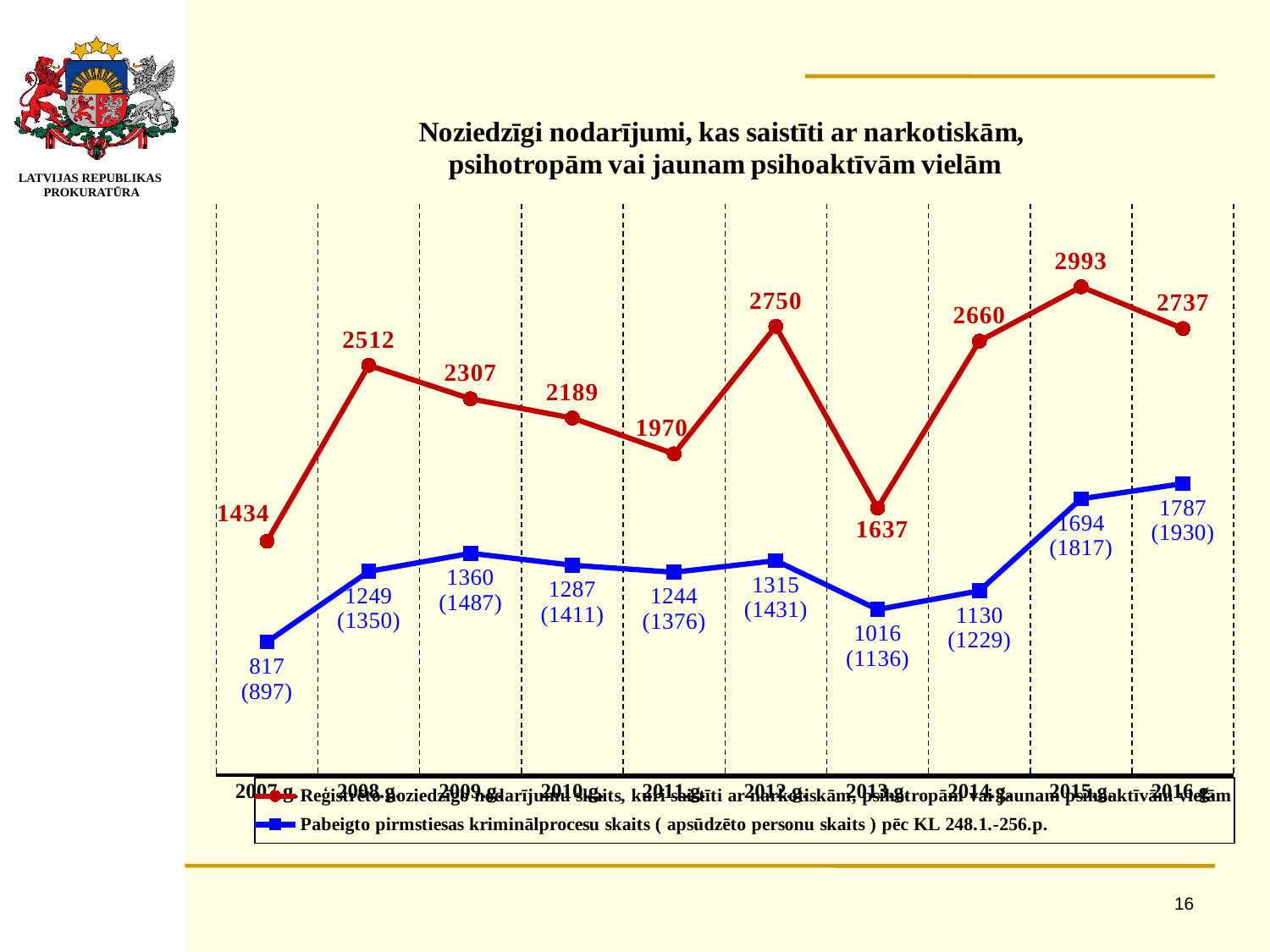
How many series does the legend list? 2 What is the difference between the blue line values for 2016 and 2015? 93 In which year does the red line reach its highest value? 2015 What is the value of the red line (registered criminal offences) for 2015? 2993 In which year does the red line have its lowest value? 2007 What is the difference between the red line values for 2012 and 2013? 1113 What is the value of the blue line (completed pre-trial criminal proceedings) for 2009? 1360 In which year does the blue line have its lowest value? 2007 What kind of chart is shown on the slide? Line chart Which is larger, the red line value for 2008 or for 2016? 2016 How many years are shown on the x axis? 10 What number is shown in parentheses for the blue line in 2016? 1930